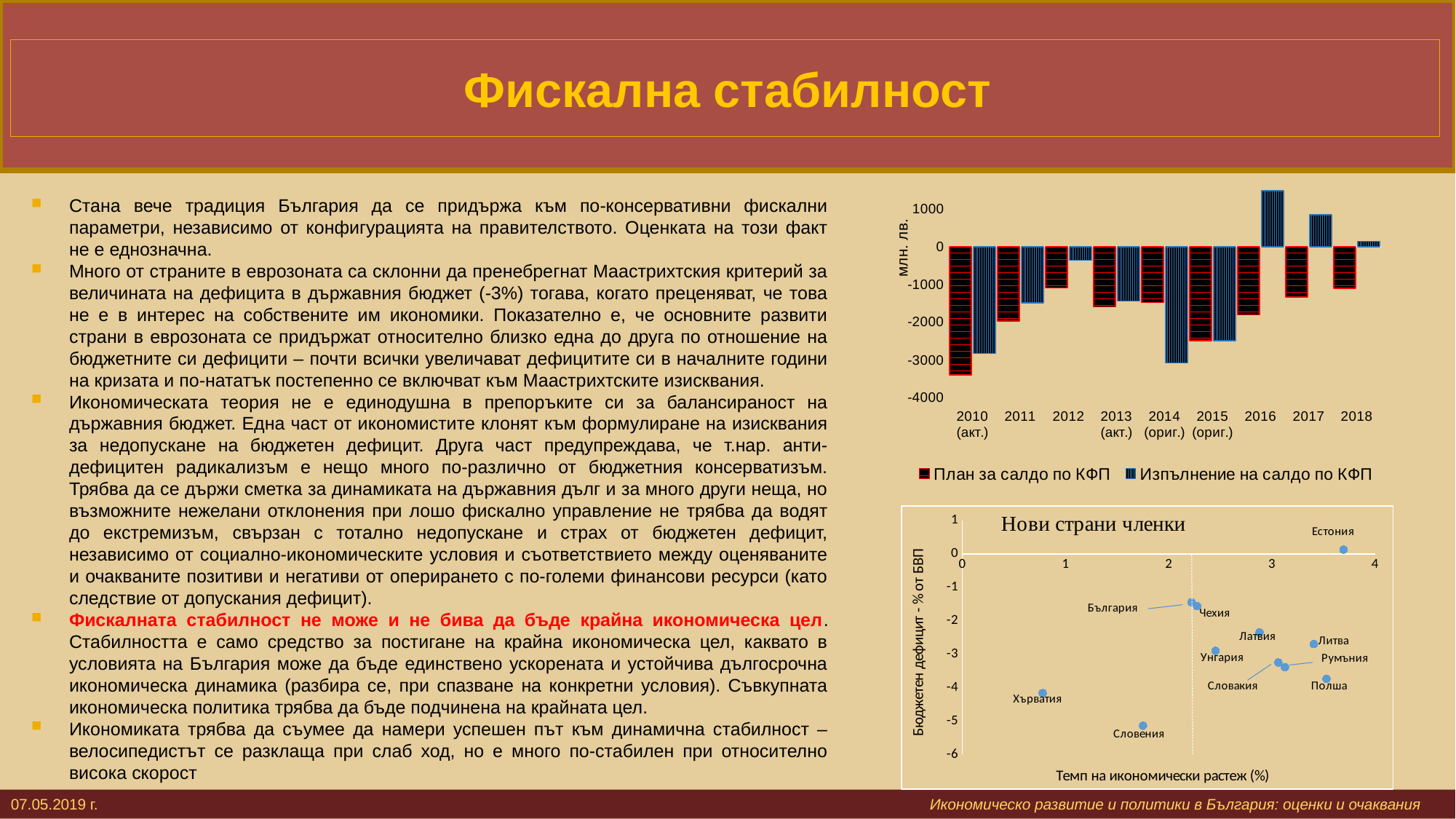
In the chart 'Нови страни членки', is the economic growth rate for Хърватия greater or less than 1? less In the top-right bar chart, which year has the highest value for 'Изпълнение на салдо по КФП'? 2016 In the top-right bar chart, what is the y-axis unit label? млн. лв. In the chart 'Нови страни членки', which country has the lowest budget deficit value? Словения In the chart 'Нови страни членки', which country has the highest budget deficit value (closest to zero)? Естония In the top-right bar chart, how many years are shown on the x axis? 9 What kind of chart is the top-right chart with years 2010 to 2018? bar chart In the top-right bar chart, is the 'План за салдо по КФП' value for 2010 greater or less than -3000? less In the top-right bar chart, is the 'Изпълнение на салдо по КФП' value for 2016 greater or less than 1000? greater What kind of chart is the chart titled 'Нови страни членки'? scatter chart In the top-right bar chart, how many series does the legend list? 2